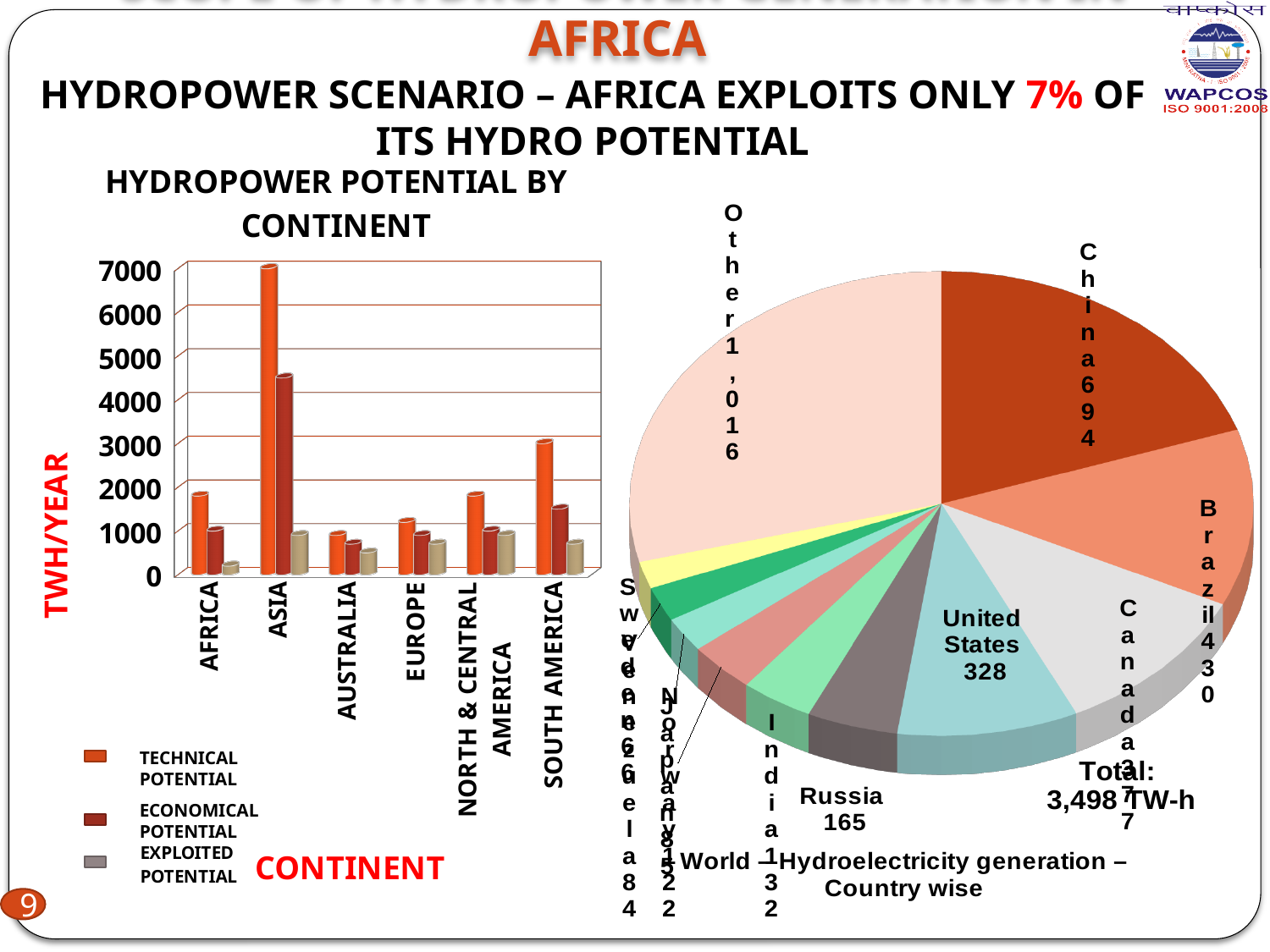
What kind of chart is the 'World – Hydroelectricity generation – Country wise' chart on the right? pie chart In the 'World – Hydroelectricity generation – Country wise' pie chart, what is the value for China? 694 In the 'HYDROPOWER POTENTIAL BY CONTINENT' chart, is the technical potential for ASIA greater or less than 6000? greater In the 'HYDROPOWER POTENTIAL BY CONTINENT' chart, how many series does the legend list? 3 What kind of chart is the 'HYDROPOWER POTENTIAL BY CONTINENT' chart on the left? bar chart In the 'World – Hydroelectricity generation – Country wise' pie chart, what is the difference between the values for China and Brazil? 264 In the 'HYDROPOWER POTENTIAL BY CONTINENT' chart, which continent has the highest technical potential? ASIA In the 'HYDROPOWER POTENTIAL BY CONTINENT' chart, is the exploited potential for AFRICA greater or less than 1000? less In the 'World – Hydroelectricity generation – Country wise' pie chart, what is the value for the United States? 328 In the 'HYDROPOWER POTENTIAL BY CONTINENT' chart, how many continents are shown on the x axis? 6 In the 'World – Hydroelectricity generation – Country wise' pie chart, which is larger, Brazil or Canada? Brazil What total is printed on the 'World – Hydroelectricity generation – Country wise' pie chart? 3,498 TW-h